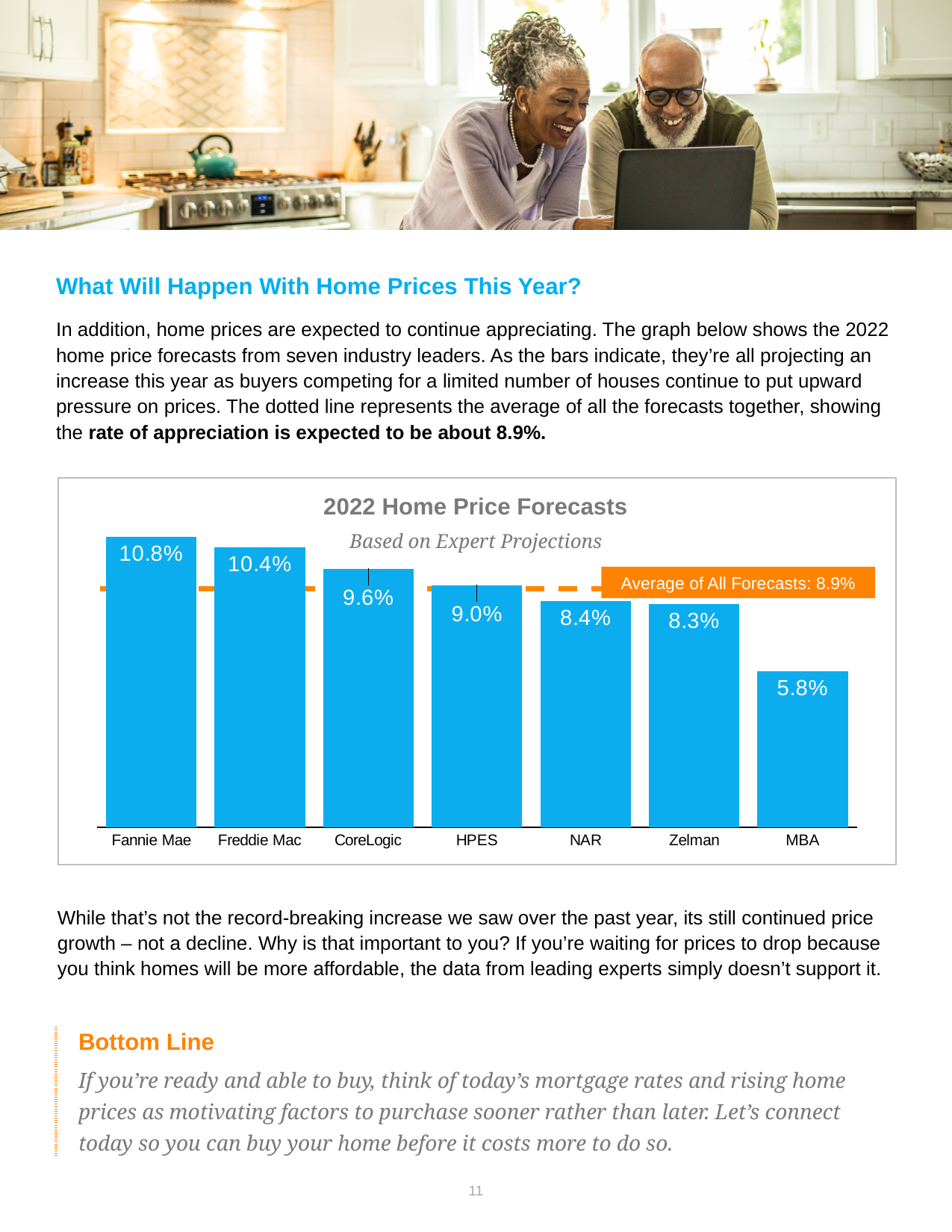
Do the forecast values rise or fall from left to right across the chart? Fall What is the 2022 home price forecast from MBA? 5.8% Which forecast is larger, NAR or Zelman? NAR What kind of chart is shown on the slide? Bar chart What is the 2022 home price forecast from Fannie Mae? 10.8% What is the average of all forecasts shown by the dotted line? 8.9% What is the difference between the Freddie Mac and HPES forecasts? 1.4% Which forecaster has the highest 2022 home price forecast? Fannie Mae Which forecaster has the lowest 2022 home price forecast? MBA What is the difference between the Fannie Mae and MBA forecasts? 5.0% How many forecasters are shown in the chart? 7 What is the 2022 home price forecast from CoreLogic? 9.6%